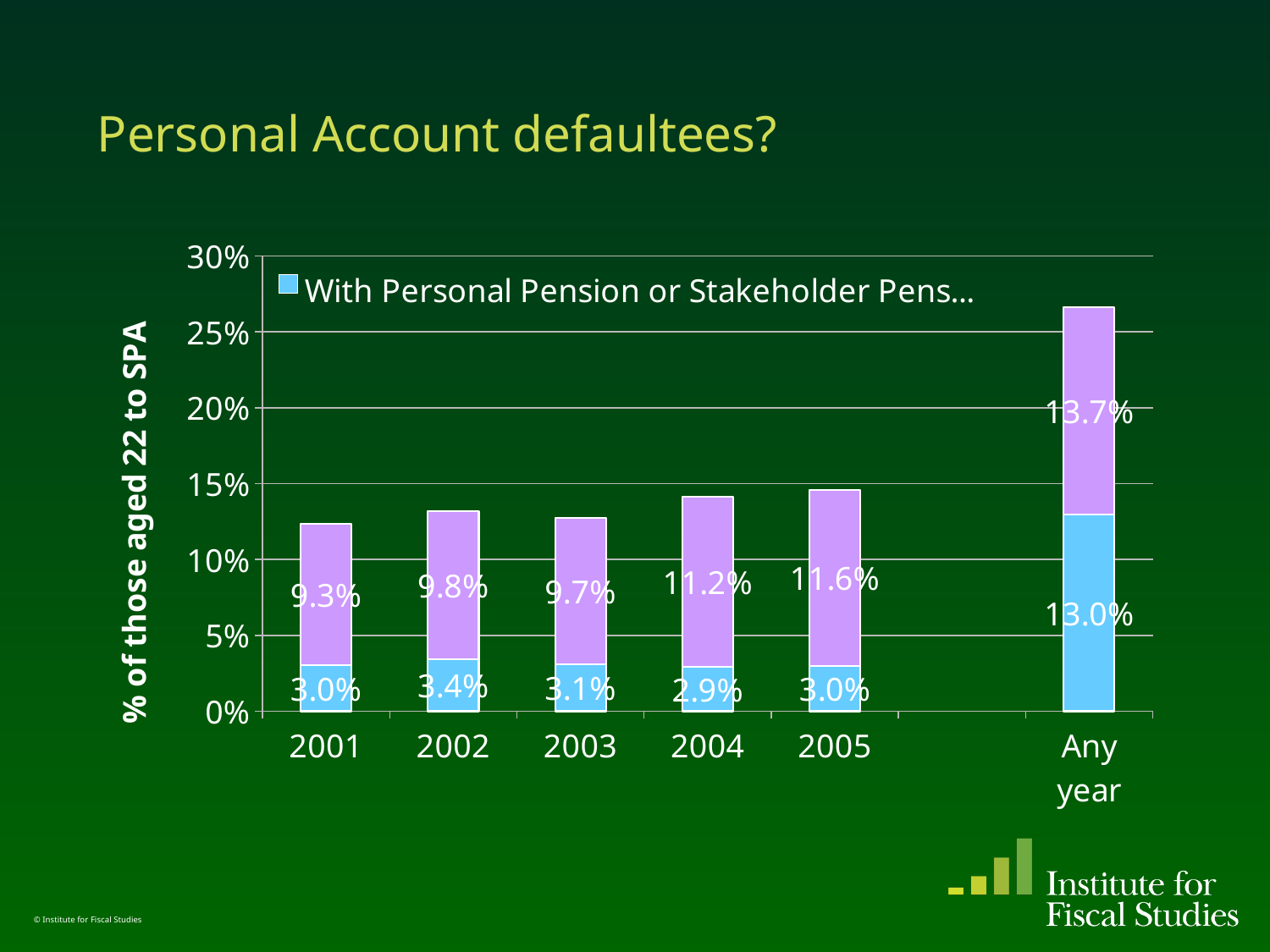
What is the total of the stacked bar for 2001? 12.3% What is the value for 2001 in the 'With Personal Pension or Stakeholder Pens...' series? 3.0% How many categories are shown on the x axis? 6 What is the difference between the 'Any year' and 2005 values in the 'With Personal Pension or Stakeholder Pens...' series? 10.0% What kind of chart is shown on the slide? Stacked bar chart What value is printed on the upper (purple) segment of the 2004 bar? 11.2% What is the title of the y axis? % of those aged 22 to SPA Which category has the highest value in the 'With Personal Pension or Stakeholder Pens...' series? Any year In the 'With Personal Pension or Stakeholder Pens...' series, which is larger: 2002 or 2003? 2002 What is the value for 'Any year' in the 'With Personal Pension or Stakeholder Pens...' series? 13.0% Which category has the lowest value in the 'With Personal Pension or Stakeholder Pens...' series? 2004 Is the total height of the 'Any year' stacked bar greater or less than 25%? greater